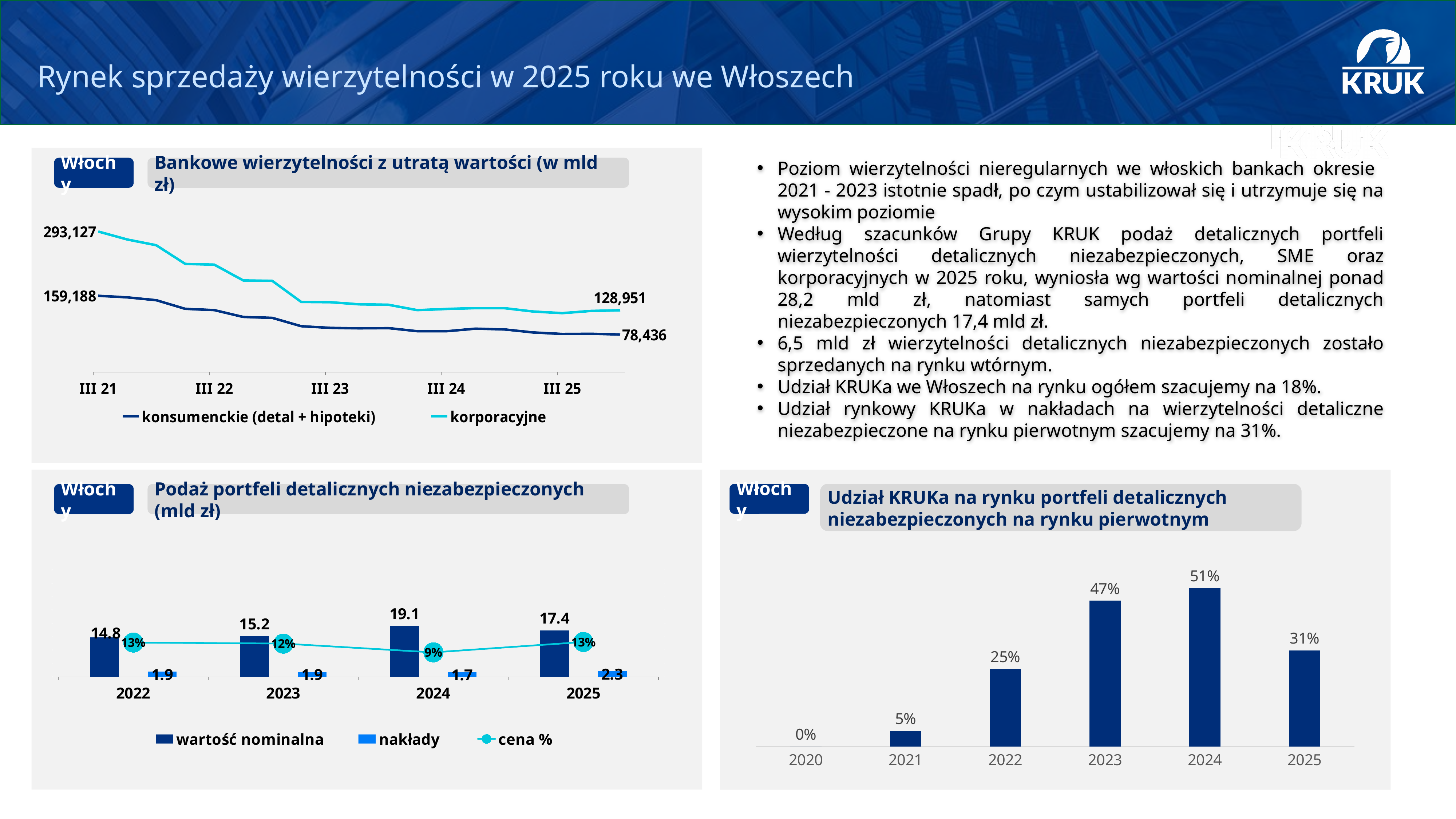
In the chart 'Podaż portfeli detalicznych niezabezpieczonych (mld zł)', which year has the lowest cena %? 2024 In the chart 'Bankowe wierzytelności z utratą wartości (w mld zł)', do the values of the korporacyjne series rise or fall from III 21 to III 25? fall In the chart 'Podaż portfeli detalicznych niezabezpieczonych (mld zł)', what is the wartość nominalna for 2024? 19.1 In the chart 'Bankowe wierzytelności z utratą wartości (w mld zł)', what is the first labelled value of the korporacyjne series? 293,127 In the chart 'Podaż portfeli detalicznych niezabezpieczonych (mld zł)', how many series does the legend list? 3 In the chart 'Bankowe wierzytelności z utratą wartości (w mld zł)', what is the last labelled value of the konsumenckie (detal + hipoteki) series? 78,436 What kind of chart is 'Udział KRUKa na rynku portfeli detalicznych niezabezpieczonych na rynku pierwotnym'? bar chart In the chart 'Udział KRUKa na rynku portfeli detalicznych niezabezpieczonych na rynku pierwotnym', which year has the highest value? 2024 In the chart 'Podaż portfeli detalicznych niezabezpieczonych (mld zł)', what is the difference between the wartość nominalna for 2024 and 2025? 1.7 In the chart 'Podaż portfeli detalicznych niezabezpieczonych (mld zł)', what is the nakłady value for 2025? 2.3 In the chart 'Udział KRUKa na rynku portfeli detalicznych niezabezpieczonych na rynku pierwotnym', what is the value for 2022? 25% In the chart 'Bankowe wierzytelności z utratą wartości (w mld zł)', how many series does the legend list? 2